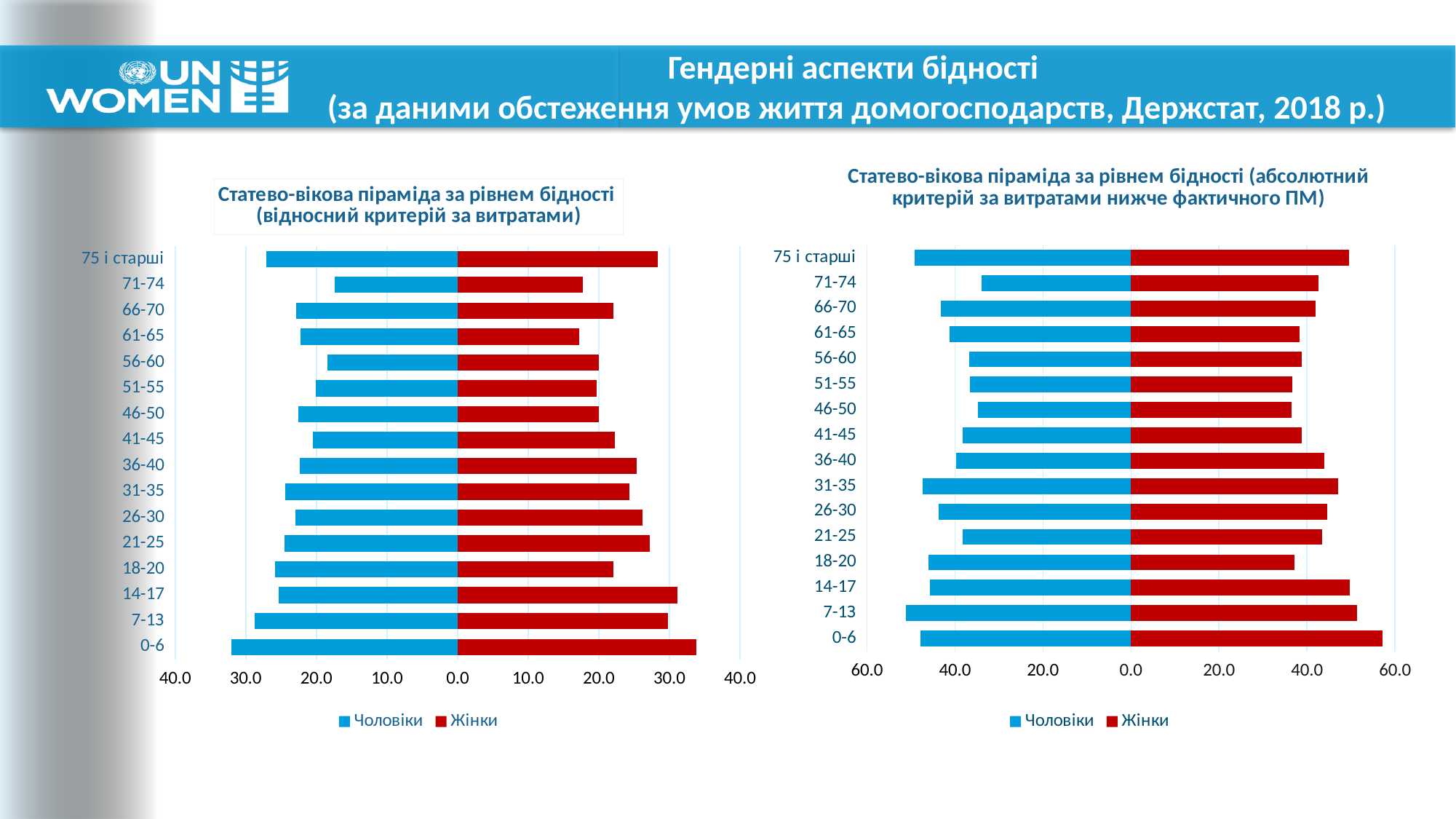
What kind of chart is the left chart (Статево-вікова піраміда за рівнем бідності (відносний критерій за витратами))? bar chart On the left chart (відносний критерій), which age group has the highest value for Жінки? 0-6 How many series does the legend of the left chart list? 2 On the left chart (відносний критерій), which age group has the highest value for Чоловіки? 0-6 On the right chart (абсолютний критерій), which age group has the lowest value for Чоловіки? 71-74 On the left chart (відносний критерій), is the value for Жінки aged 0-6 greater or less than 30.0? greater What are the two series named in the legend of the right chart? Чоловіки, Жінки On the right chart (абсолютний критерій), which age group has the highest value for Жінки? 0-6 On the left chart (відносний критерій), is the value for Чоловіки aged 71-74 greater or less than 20.0? less On the right chart (абсолютний критерій), is the value for Чоловіки aged 71-74 greater or less than 40.0? less On the right chart (абсолютний критерій), which is larger for the 0-6 age group, Чоловіки or Жінки? Жінки How many age groups are shown on the right chart (абсолютний критерій за витратами нижче фактичного ПМ)? 16